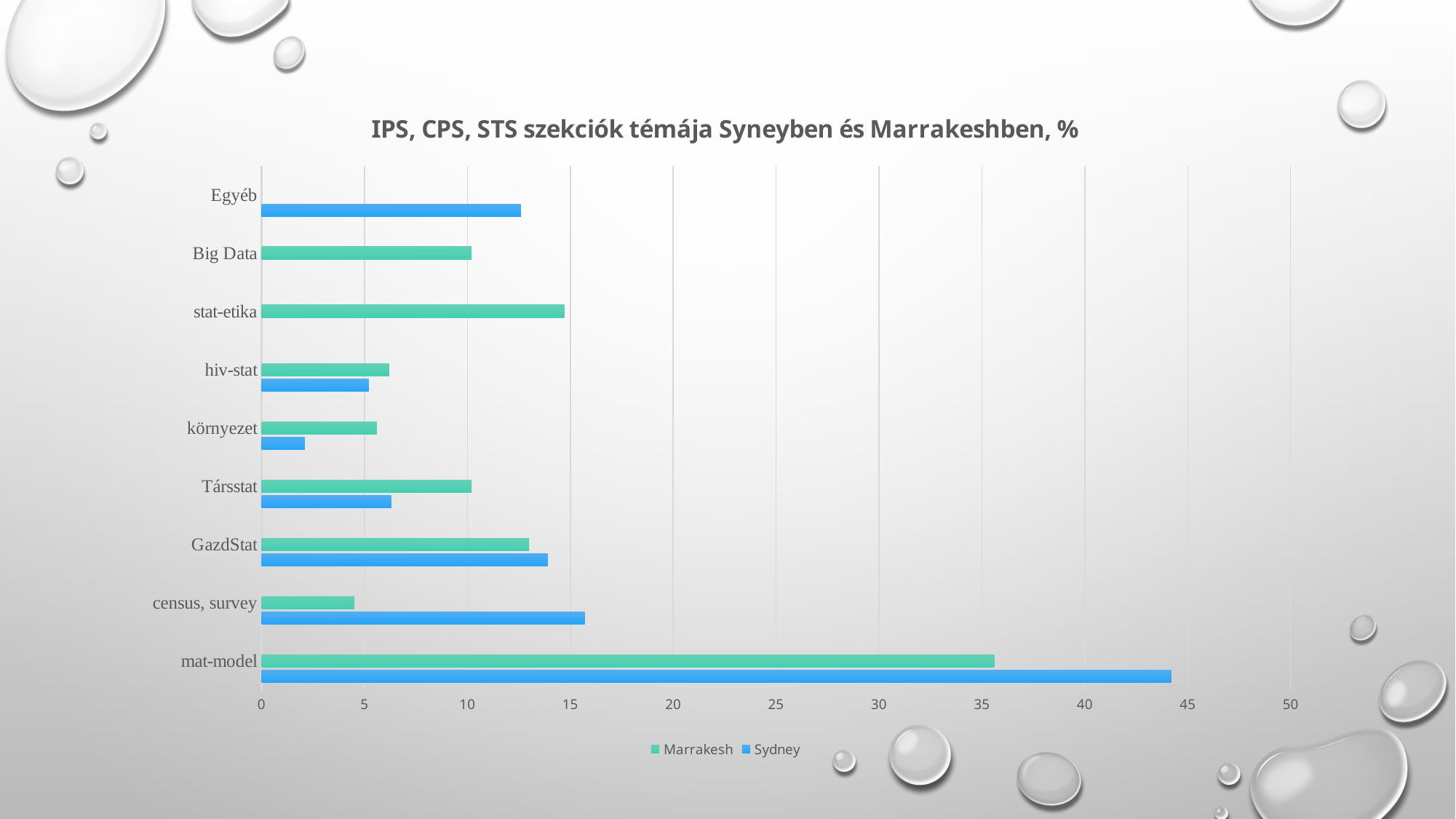
Is the Sydney value for környezet greater or less than 5? less Is the Marrakesh value for stat-etika greater or less than 10? greater For környezet, which series has the larger value, Marrakesh or Sydney? Marrakesh Which category has the highest value for Sydney? mat-model For census, survey, which series has the larger value, Marrakesh or Sydney? Sydney How many series does the legend list? 2 Which category has the highest value for Marrakesh? mat-model How many categories are shown on the vertical axis? 9 What is the title of the chart? IPS, CPS, STS szekciók témája Syneyben és Marrakeshben, % Is the Sydney value for mat-model greater or less than 40? greater For mat-model, which series has the larger value, Marrakesh or Sydney? Sydney What kind of chart is shown on the slide? bar chart